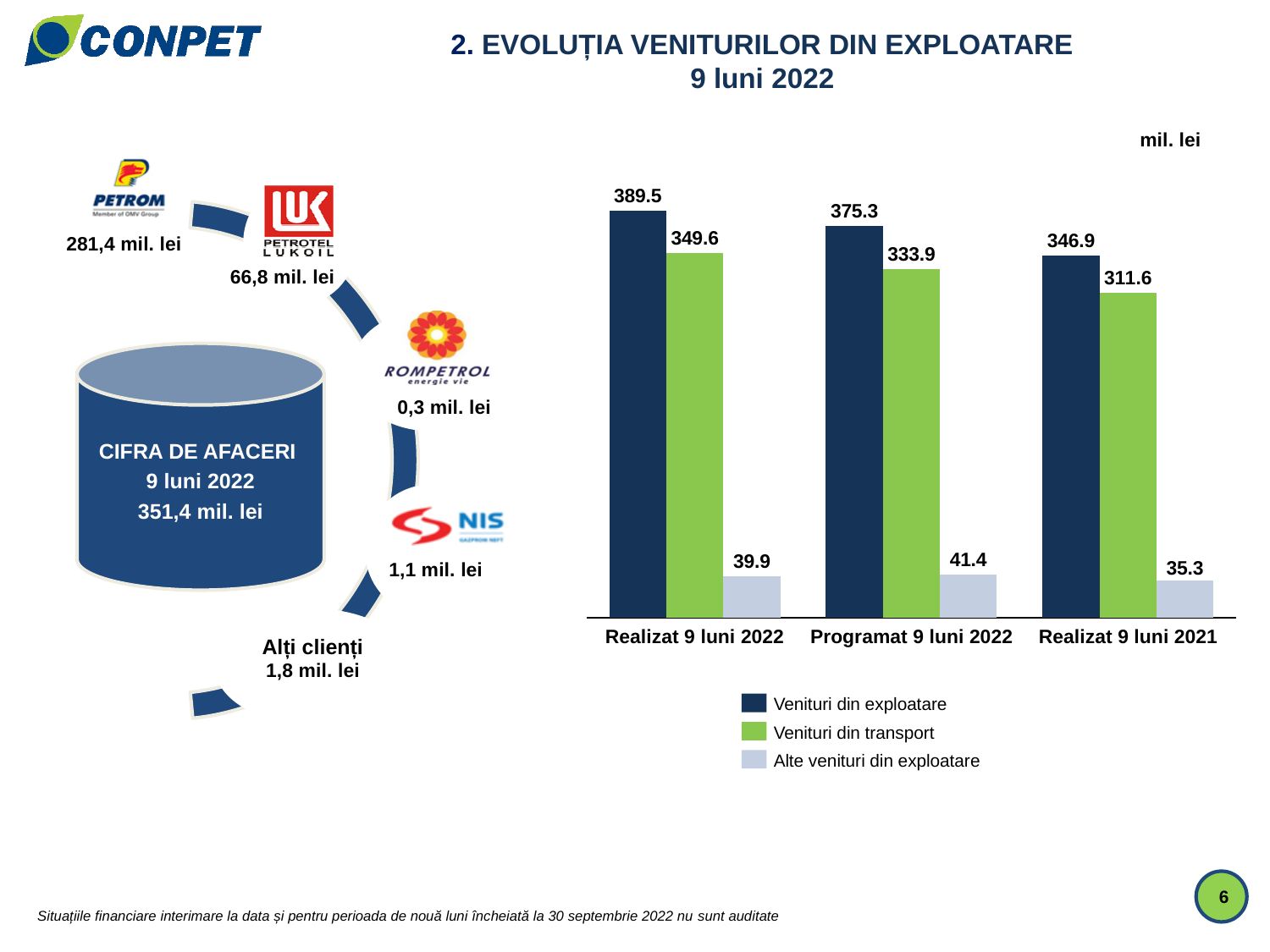
Do the values for Venituri din exploatare rise or fall from left to right across the categories? fall What is the value of Venituri din exploatare for Realizat 9 luni 2022? 389.5 Which category has the highest value for Venituri din exploatare? Realizat 9 luni 2022 What kind of chart is shown on the slide? bar chart What is the value of Alte venituri din exploatare for Realizat 9 luni 2021? 35.3 How many series does the chart legend list? 3 What unit is indicated above the chart? mil. lei Which category has the lowest value for Alte venituri din exploatare? Realizat 9 luni 2021 Which is larger: Venituri din transport for Realizat 9 luni 2022 or for Programat 9 luni 2022? Realizat 9 luni 2022 How many categories are shown on the x axis of the chart? 3 What is the difference between Venituri din exploatare for Realizat 9 luni 2022 and Realizat 9 luni 2021? 42.6 What is the value of Venituri din transport for Programat 9 luni 2022? 333.9